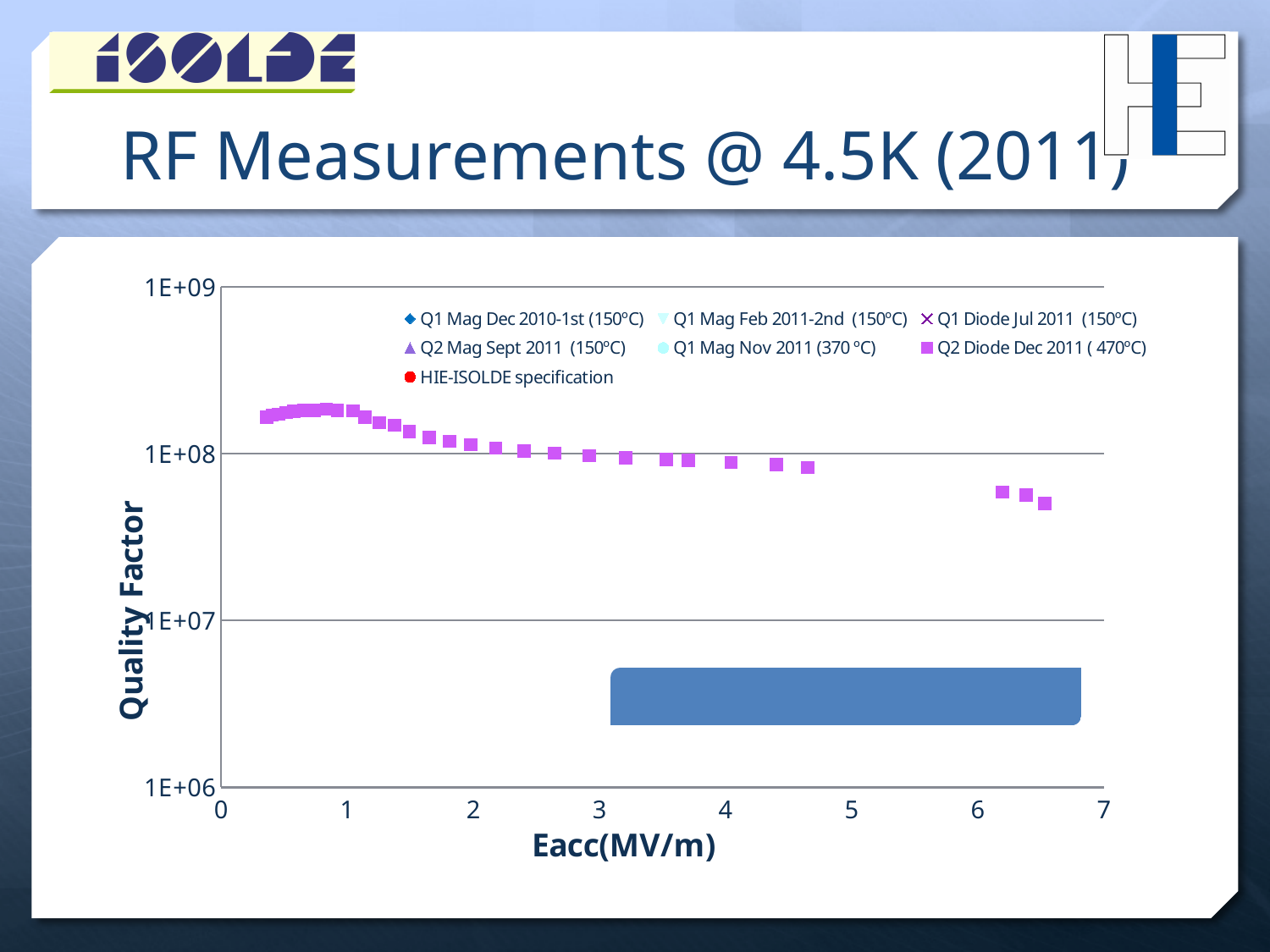
Is the Quality Factor of the plotted points near Eacc = 6.5 MV/m greater or less than 1E+08? less Is the Quality Factor of the plotted points near Eacc = 1 MV/m greater or less than 1E+08? greater What kind of chart is shown on the slide? scatter chart Is the Quality Factor of the plotted points near Eacc = 6.5 MV/m greater or less than 1E+07? greater What is the highest tick value shown on the y axis? 1E+09 What is the label of the x axis? Eacc(MV/m) What is the label of the y axis? Quality Factor How many series does the chart legend list? 7 Do the plotted Quality Factor values rise or fall as Eacc increases beyond about 1 MV/m? fall Which is larger, the Quality Factor of the plotted points near Eacc = 1 MV/m or near Eacc = 6.5 MV/m? near Eacc = 1 MV/m